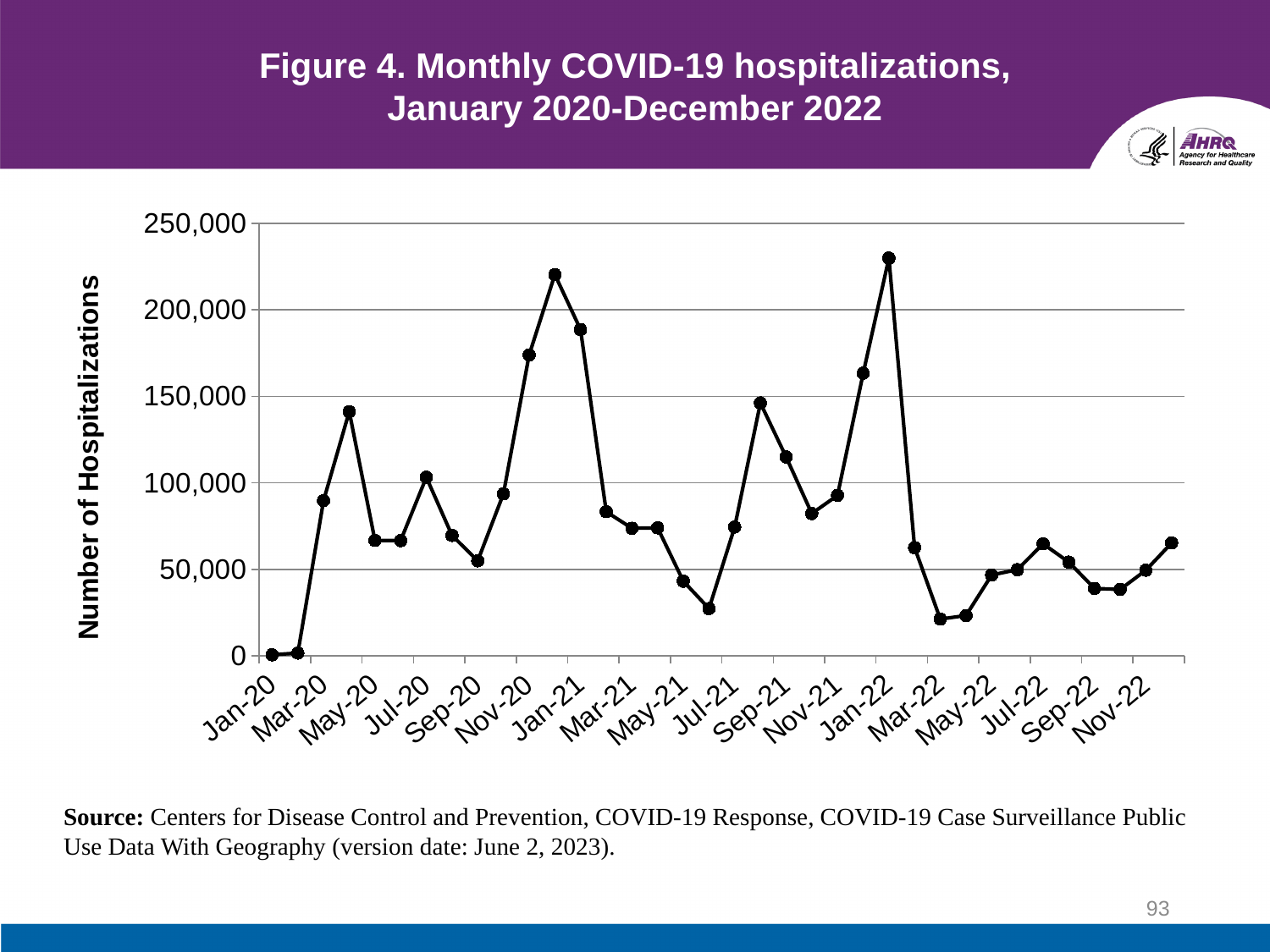
Which is larger, the value for Dec-20 or the value for Jan-22? Jan-22 How many monthly data points are plotted on the chart? 36 Is the value for Nov-20 greater or less than 150,000? greater Is the value for Jan-22 greater or less than 200,000? greater Is the value for Jul-21 greater or less than 50,000? greater What is the label on the vertical axis? Number of Hospitalizations Do the values rise or fall from Jan-22 to Mar-22? fall What is the title of the chart? Figure 4. Monthly COVID-19 hospitalizations, January 2020-December 2022 Which is larger, the value for Apr-20 or the value for Jul-20? Apr-20 What kind of chart is shown on the slide? line chart Which month has the highest number of hospitalizations? Jan-22